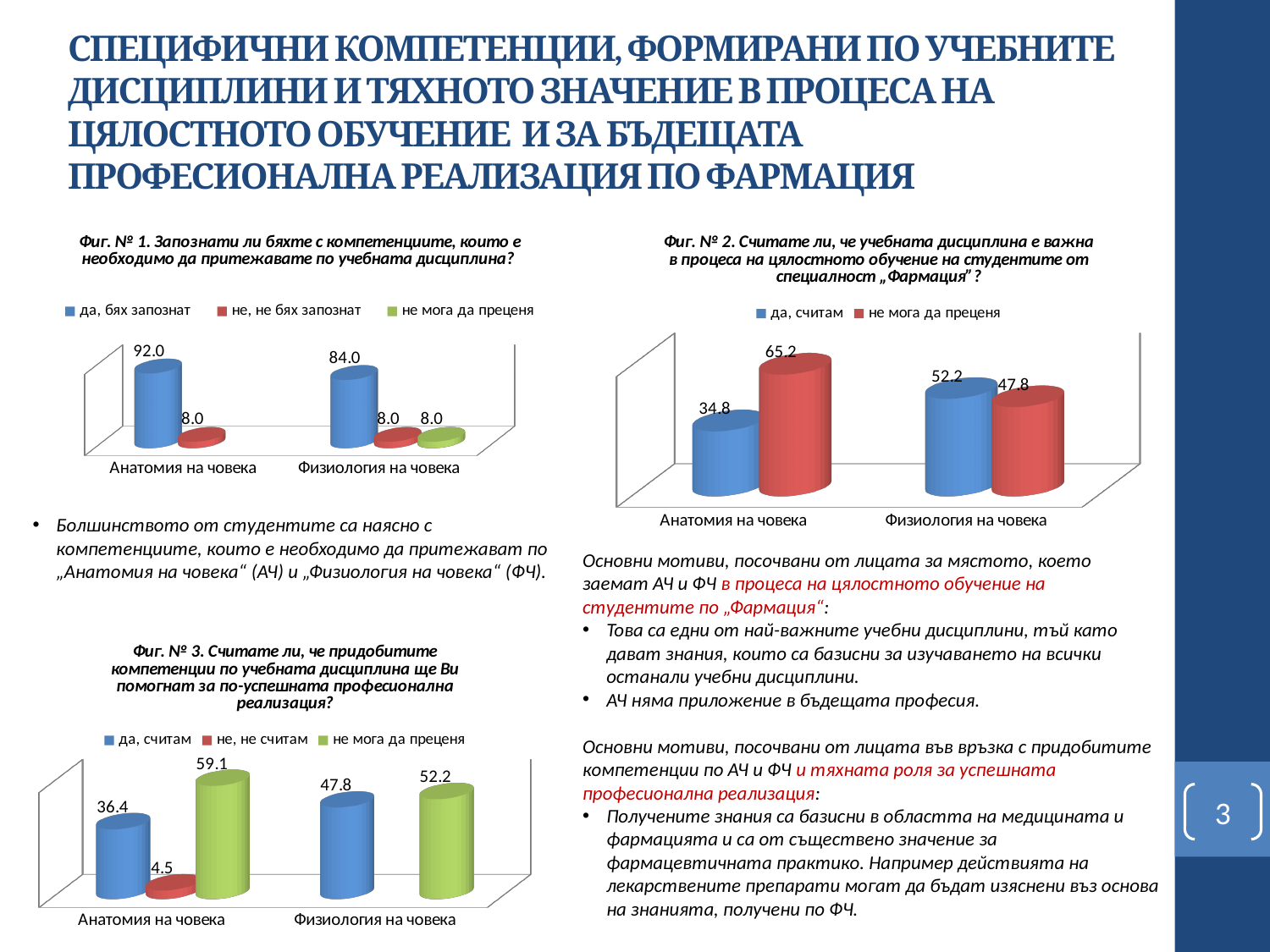
In Fig. № 3, what is the value for "не мога да преценя" for Физиология на човека? 52.2 In Fig. № 2, what is the value for "да, считам" for Физиология на човека? 52.2 In Fig. № 2, what is the value for "не мога да преценя" for Анатомия на човека? 65.2 What type of chart is Fig. № 3? bar chart In Fig. № 3, which series has the highest value for Анатомия на човека? не мога да преценя In Fig. № 1, how many series does the legend list? 3 In Fig. № 2, what is the difference between "не мога да преценя" and "да, считам" for Анатомия на човека? 30.4 In Fig. № 1, what is the value for "да, бях запознат" for Физиология на човека? 84.0 In Fig. № 1, what is the difference between the "да, бях запознат" values for Анатомия на човека and Физиология на човека? 8.0 In Fig. № 3, what is the value for "не, не считам" for Анатомия на човека? 4.5 In Fig. № 2, which is larger for Анатомия на човека: "да, считам" or "не мога да преценя"? не мога да преценя In Fig. № 1, what is the value for "да, бях запознат" for Анатомия на човека? 92.0